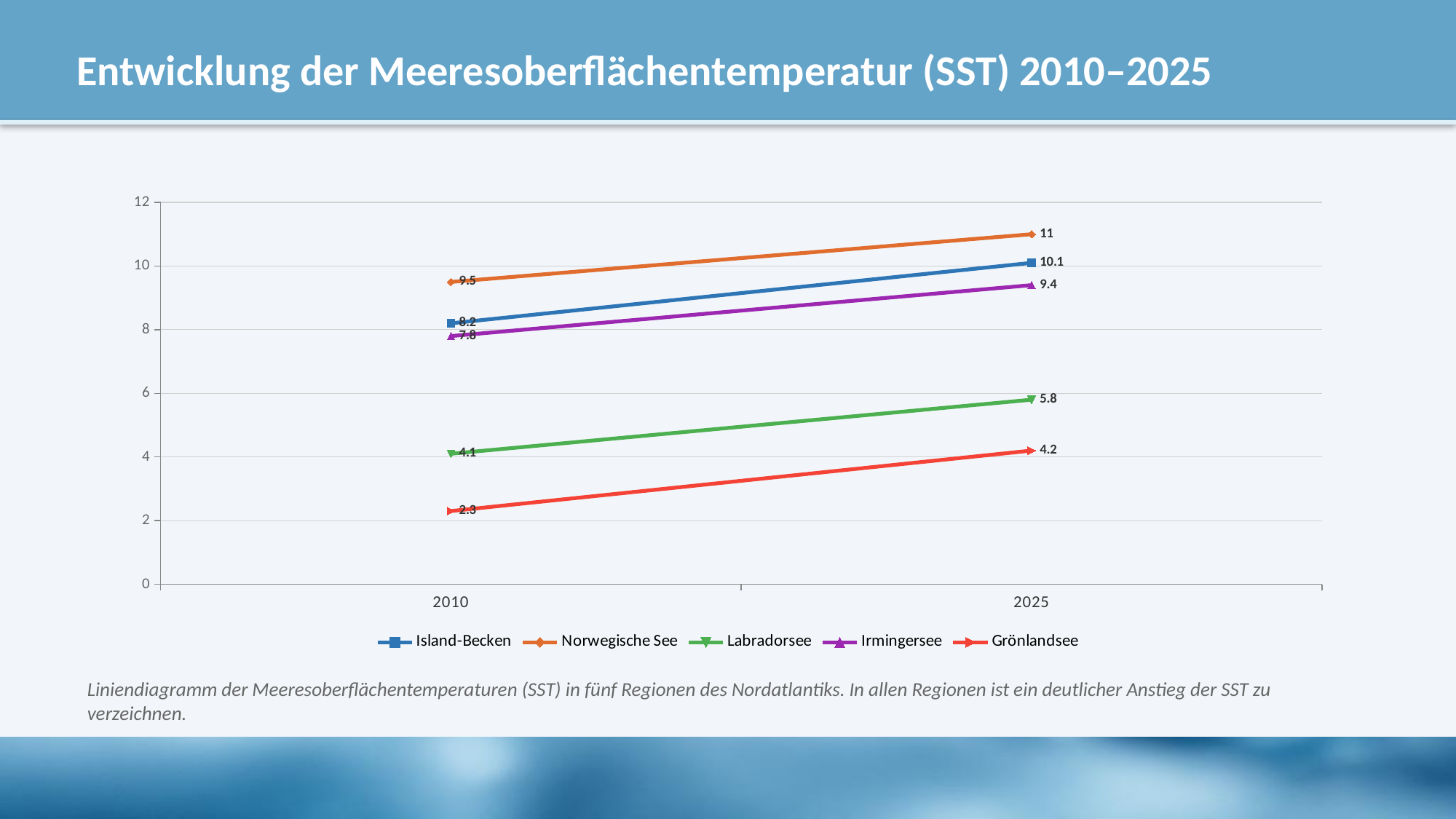
How many series does the legend list? 5 Which is larger in 2025: Irmingersee or Labradorsee? Irmingersee What is the value for Irmingersee in 2010? 7.8 What is the value for Grönlandsee in 2010? 2.3 What kind of chart is shown on the slide? Line chart Which series has the lowest value in 2010? Grönlandsee What is the value for Norwegische See in 2025? 11 Which series has the highest value in 2025? Norwegische See What is the value for Labradorsee in 2025? 5.8 What is the title of the slide? Entwicklung der Meeresoberflächentemperatur (SST) 2010–2025 What is the difference between the Island-Becken values in 2025 and 2010? 1.9 Do the values for Grönlandsee rise or fall from 2010 to 2025? Rise